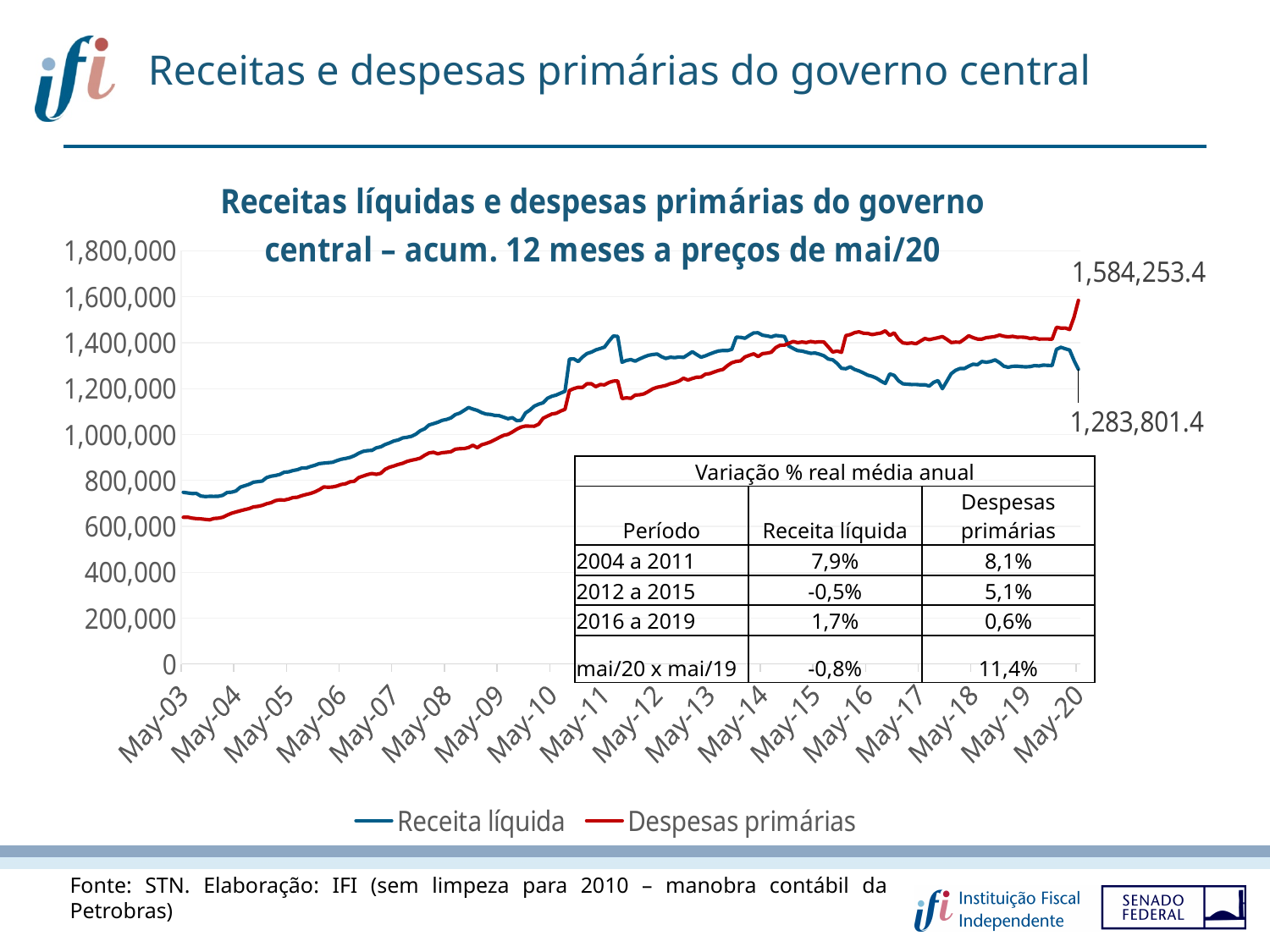
Is the value for Receita líquida at May-08 greater or less than 1,200,000? less Is the value for Despesas primárias at May-03 greater or less than 800,000? less Is the value for Receita líquida at May-03 greater or less than 800,000? less What is the value of Receita líquida at May-20? 1,283,801.4 What is the value of Despesas primárias at May-20? 1,584,253.4 How many series does the chart legend list? 2 Does the Despesas primárias series rise or fall overall from May-03 to May-20? rise What are the two series named in the chart legend? Receita líquida and Despesas primárias What kind of chart is shown on the slide? line chart What is the difference between Despesas primárias and Receita líquida at May-20? 300,452.0 At May-20, which series is larger, Receita líquida or Despesas primárias? Despesas primárias At May-17, which series is larger, Receita líquida or Despesas primárias? Despesas primárias